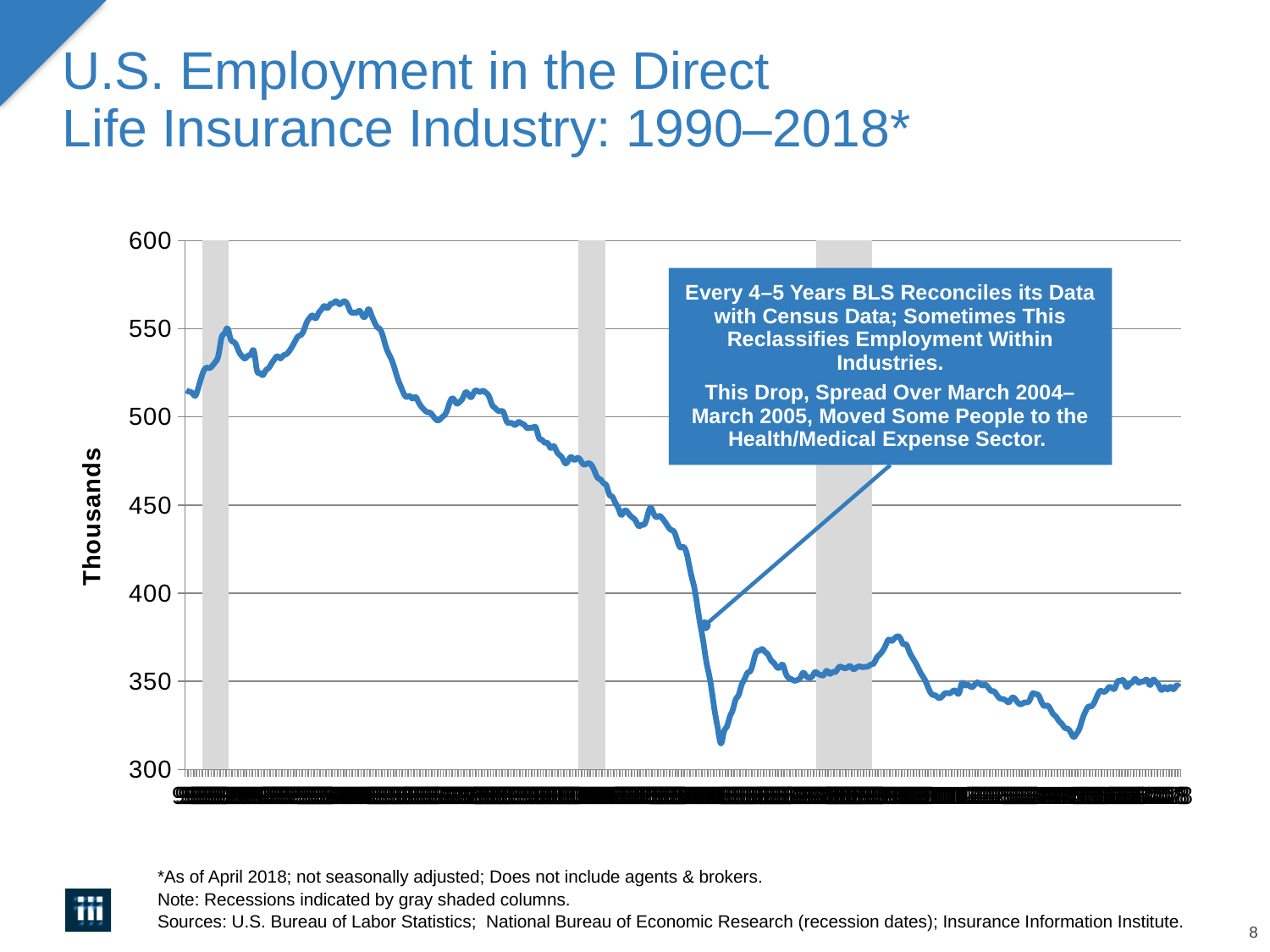
How many gray shaded recession columns appear on the chart? 3 Is the value at the left-hand start of the line greater or less than 500? greater Is the lowest point on the line greater or less than 350? less Is the value at the right-hand end of the line greater or less than 400? less What kind of chart is shown on the slide? line chart What is the highest value shown on the vertical axis of the chart? 600 What is the label on the vertical axis of the chart? Thousands Overall, does the line rise or fall from the left of the chart to the right? fall What is the title of the chart on the slide? U.S. Employment in the Direct Life Insurance Industry: 1990–2018*